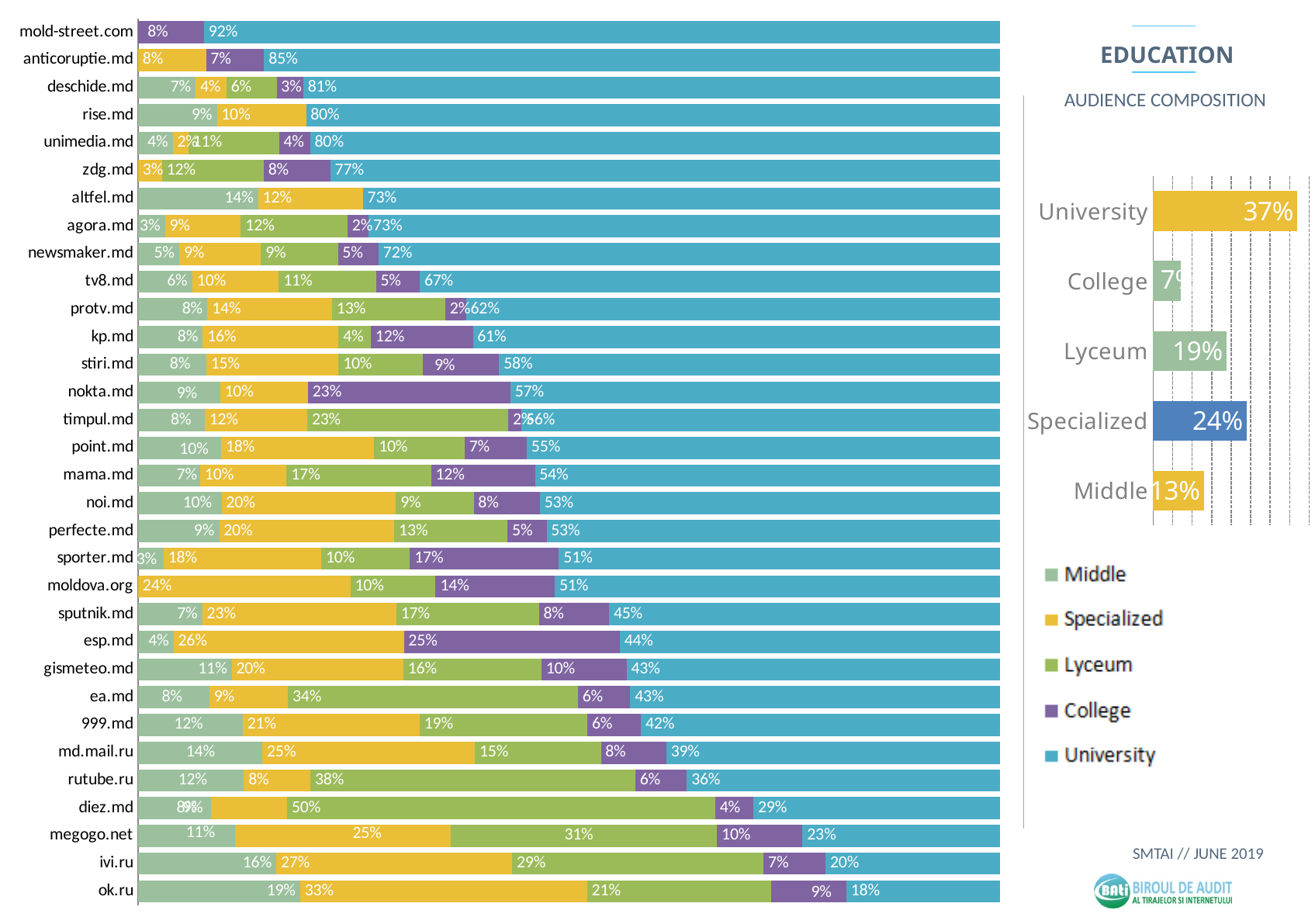
What kind of chart is the large chart on the left? Stacked bar chart In the stacked bar chart on the left, what is the difference in percentage points between the University share of mold-street.com and that of ok.ru? 74 percentage points How many series does the legend of the stacked bar chart list? 5 How many websites are shown in the stacked bar chart on the left? 32 In the stacked bar chart on the left, what is the Specialized share for esp.md? 26% In the stacked bar chart on the left, which website has the highest University share? mold-street.com In the stacked bar chart on the left, what is the University share for mold-street.com? 92% In the stacked bar chart on the left, which website has the lowest University share? ok.ru In the Audience Composition chart on the right, what is the value for University? 37% In the Audience Composition chart on the right, what is the difference in percentage points between University and Specialized? 13 percentage points In the stacked bar chart on the left, what is the Lyceum share for diez.md? 50% In the stacked bar chart on the left, which has the larger University share, sputnik.md or rutube.ru? sputnik.md